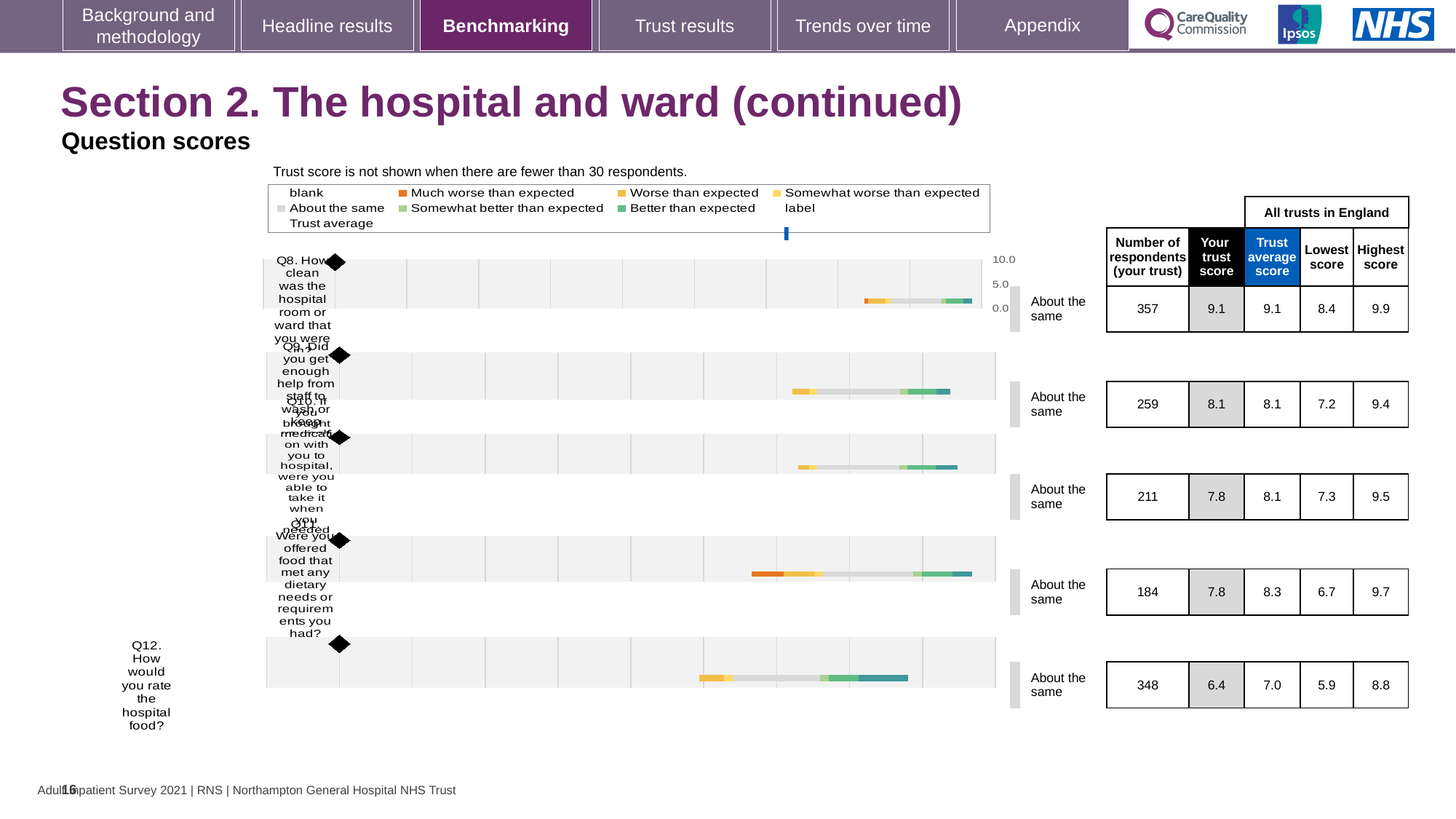
Which question has the highest number of respondents for your trust? Q8 Which question has the lowest 'Your trust score' on this slide? Q12 What is the highest score across all trusts in England for Q9 (Did you get enough help from staff to wash or keep yourself clean)? 9.4 Is your trust score for Q12 greater or less than 5.0? greater What is the 'Your trust score' value for Q8 (How clean was the hospital room or ward)? 9.1 What kind of chart is used to show the question scores? Bar chart What is the lowest score across all trusts in England for Q11 (Were you offered food that met any dietary needs or requirements you had)? 6.7 How many respondents from your trust answered Q12 (How would you rate the hospital food)? 348 What benchmark category label is shown next to Q10 (If you brought medication with you to hospital, were you able to take it when you needed)? About the same Which has the larger 'Your trust score': Q8 or Q12? Q8 How many questions are plotted on this slide? 5 For Q12, what is the difference between the trust average score and your trust score? 0.6